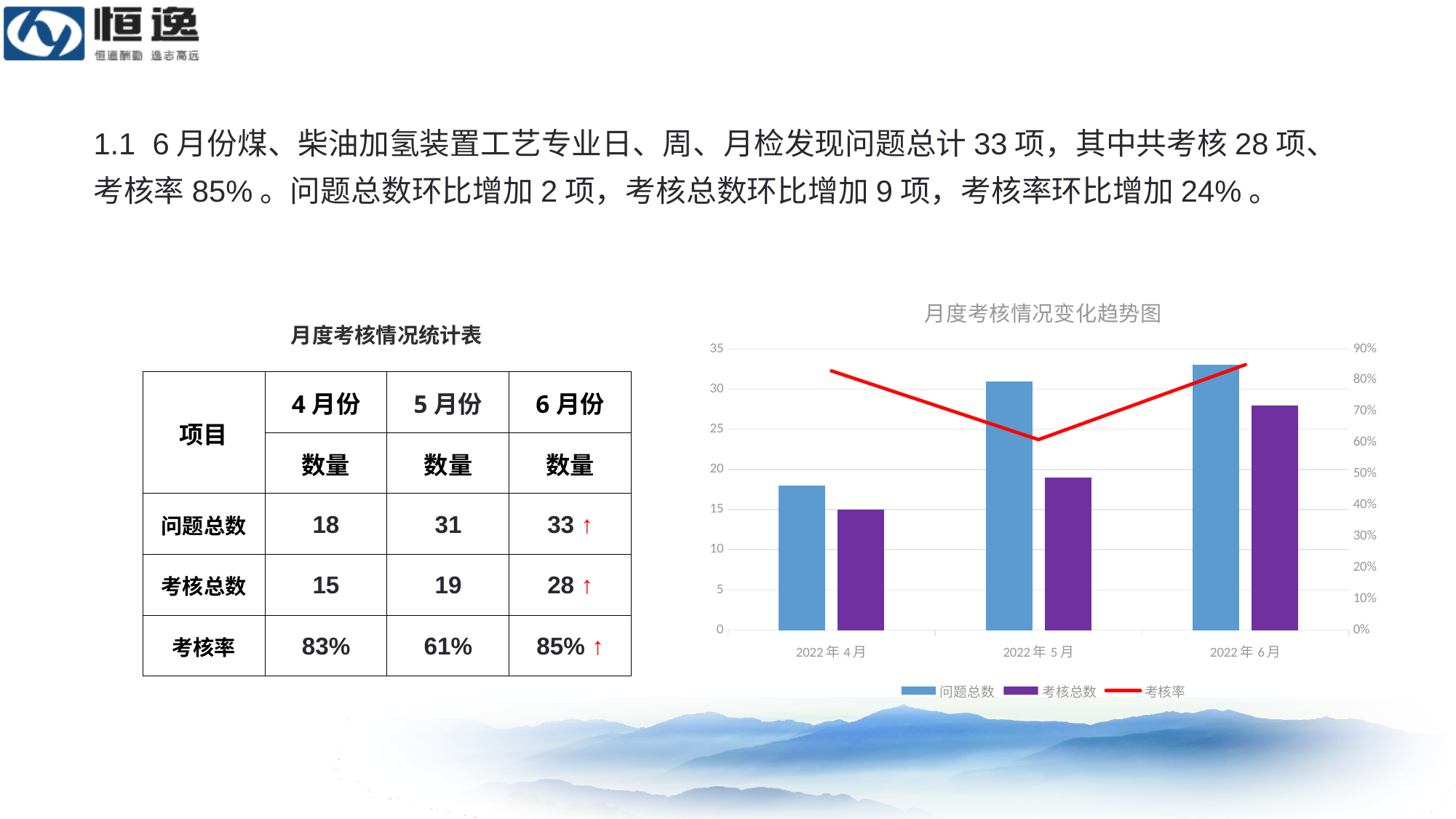
In 月度考核情况变化趋势图, which is larger for 2022年4月: 问题总数 or 考核总数? 问题总数 What kind of chart is 月度考核情况变化趋势图? A bar chart with a line series In 月度考核情况变化趋势图, does 问题总数 rise or fall from 2022年4月 to 2022年6月? rise How many months are shown on the x axis of 月度考核情况变化趋势图? 3 What colour is the 考核率 line in 月度考核情况变化趋势图? Red How many series does the legend of 月度考核情况变化趋势图 list? 3 In 月度考核情况变化趋势图, which month has the lowest 考核率? 2022年5月 In 月度考核情况变化趋势图, what is the 考核总数 for 2022年4月? 15 In 月度考核情况变化趋势图, is the 问题总数 for 2022年5月 greater or less than 25? greater What is the difference between 问题总数 and 考核总数 for 2022年6月 in 月度考核情况变化趋势图? 5 In 月度考核情况变化趋势图, which month has the highest 问题总数? 2022年6月 In 月度考核情况变化趋势图, is the 考核率 for 2022年5月 greater or less than 70%? less